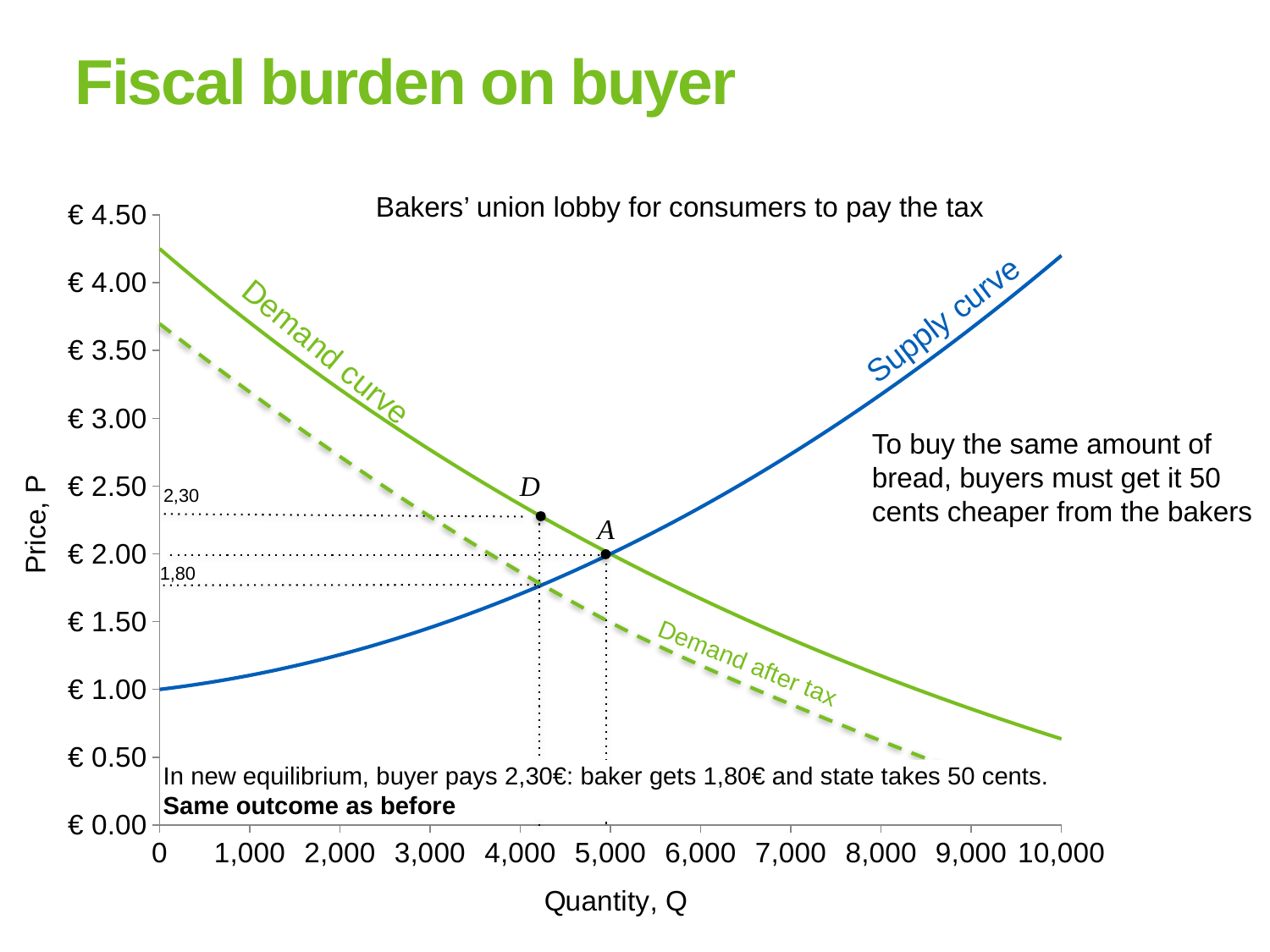
What is the price at point A, the original equilibrium? € 2.00 What is the quantity at point A? 5,000 How many curves are plotted on the chart? 3 Is the quantity at point D greater or less than 5,000? less What is the title printed above the chart? Bakers' union lobby for consumers to pay the tax What is the difference between the price the buyer pays (2,30) and the price the baker gets (1,80)? 50 cents Does the Demand curve rise or fall as quantity increases? fall At quantity 0, which curve is higher: the Demand curve or the Supply curve? Demand curve What price is marked at point D on the chart? 2,30 Which curve is drawn as a dashed line? Demand after tax What price does the baker receive after the tax, as labelled on the chart? 1,80 What kind of chart is shown on the slide? line chart